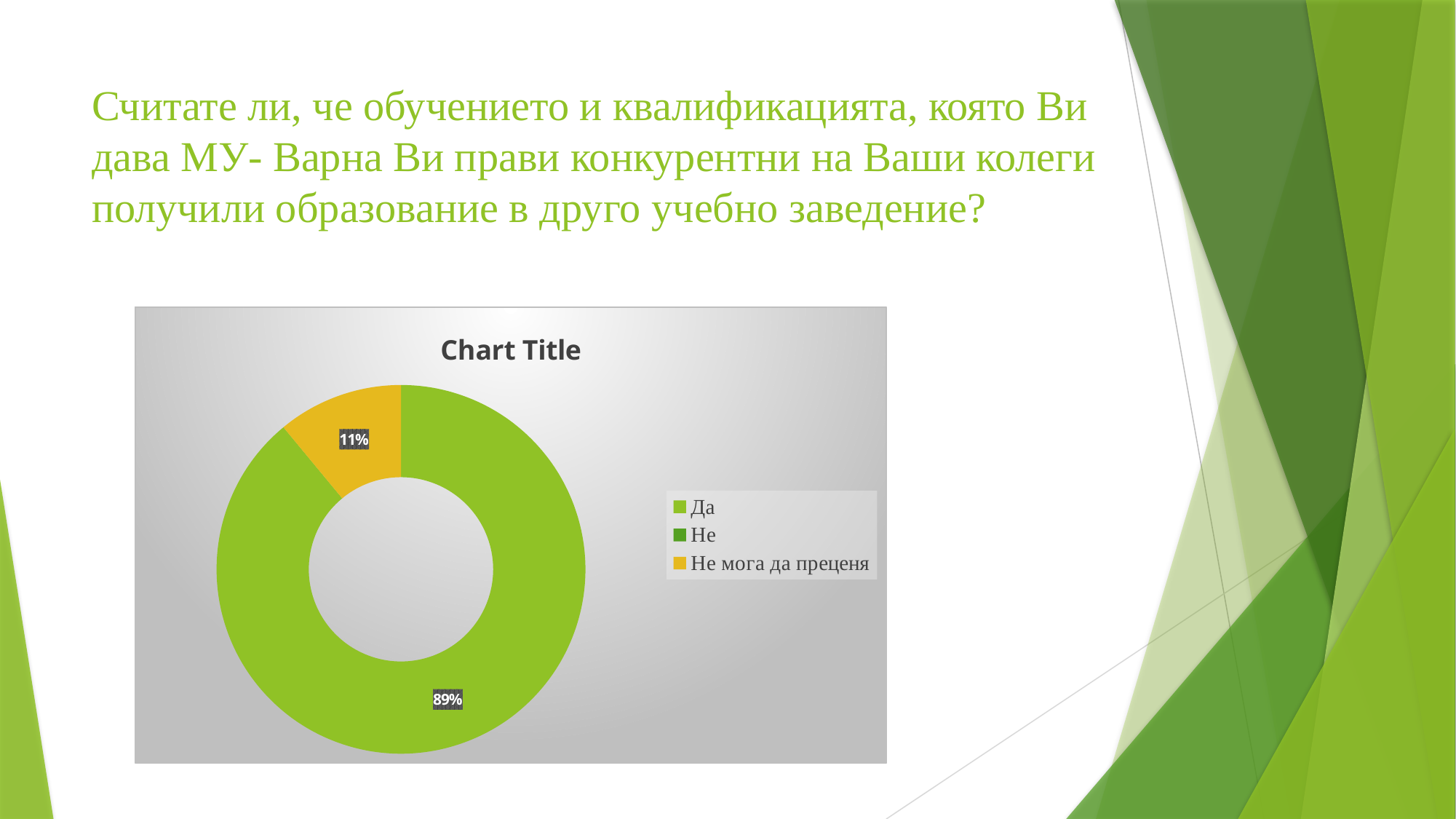
Which of the two labelled slices is smaller, "Да" or "Не мога да преценя"? Не мога да преценя What is the value shown for "Да"? 89% What is the value shown for "Не мога да преценя"? 11% What share of the doughnut does "Да" represent? 89% What colour is the slice for "Не мога да преценя"? Yellow Which is larger, the share for "Да" or the share for "Не мога да преценя"? Да How many categories does the legend list? 3 What kind of chart is shown on the slide? Doughnut chart What is the difference between the shares for "Да" and "Не мога да преценя"? 78% What is the title printed above the chart? Chart Title Which category has the largest share of the doughnut? Да